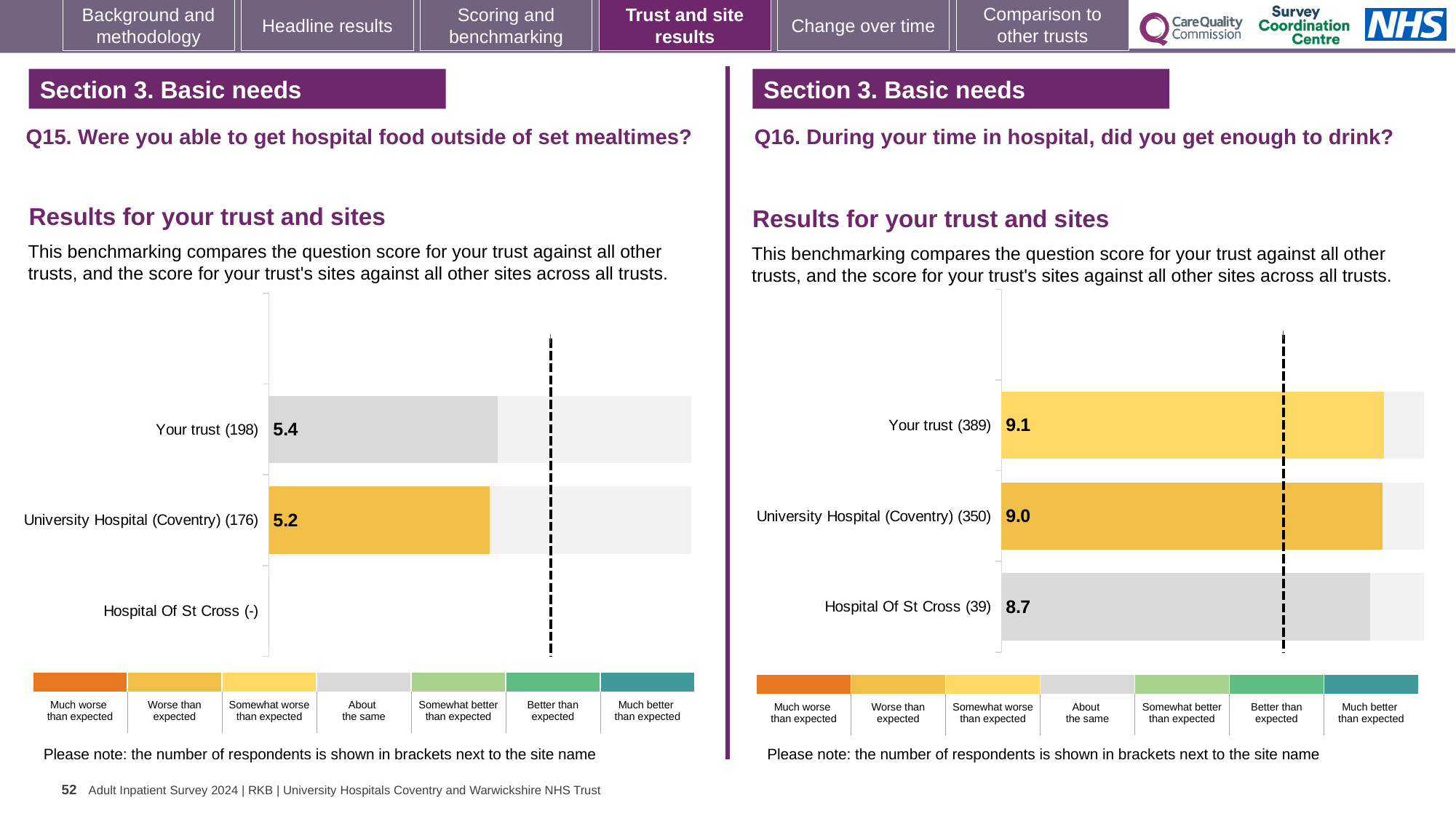
On the Q16 chart (right), which site or trust row has the lowest score? Hospital Of St Cross On the Q16 chart (right), which is larger: the score for University Hospital (Coventry) or the score for Hospital Of St Cross? University Hospital (Coventry) On the Q15 chart (left), what is the score for Your trust? 5.4 On the Q15 chart (left), what is the score for University Hospital (Coventry)? 5.2 On the Q15 chart (left), how many respondents are shown in brackets for Your trust? 198 On the Q15 chart (left), how many rows (trust and sites) are listed on the vertical axis? 3 On the Q15 chart (left), what is the difference between the Your trust score and the University Hospital (Coventry) score? 0.2 On the Q16 chart (right), what is the score for Your trust? 9.1 What kind of chart is used on the Q16 chart (right)? Bar chart On the Q16 chart (right), what is the difference between the Your trust score and the Hospital Of St Cross score? 0.4 On the Q16 chart (right), which row has the highest score? Your trust On the Q16 chart (right), what is the score for Hospital Of St Cross? 8.7